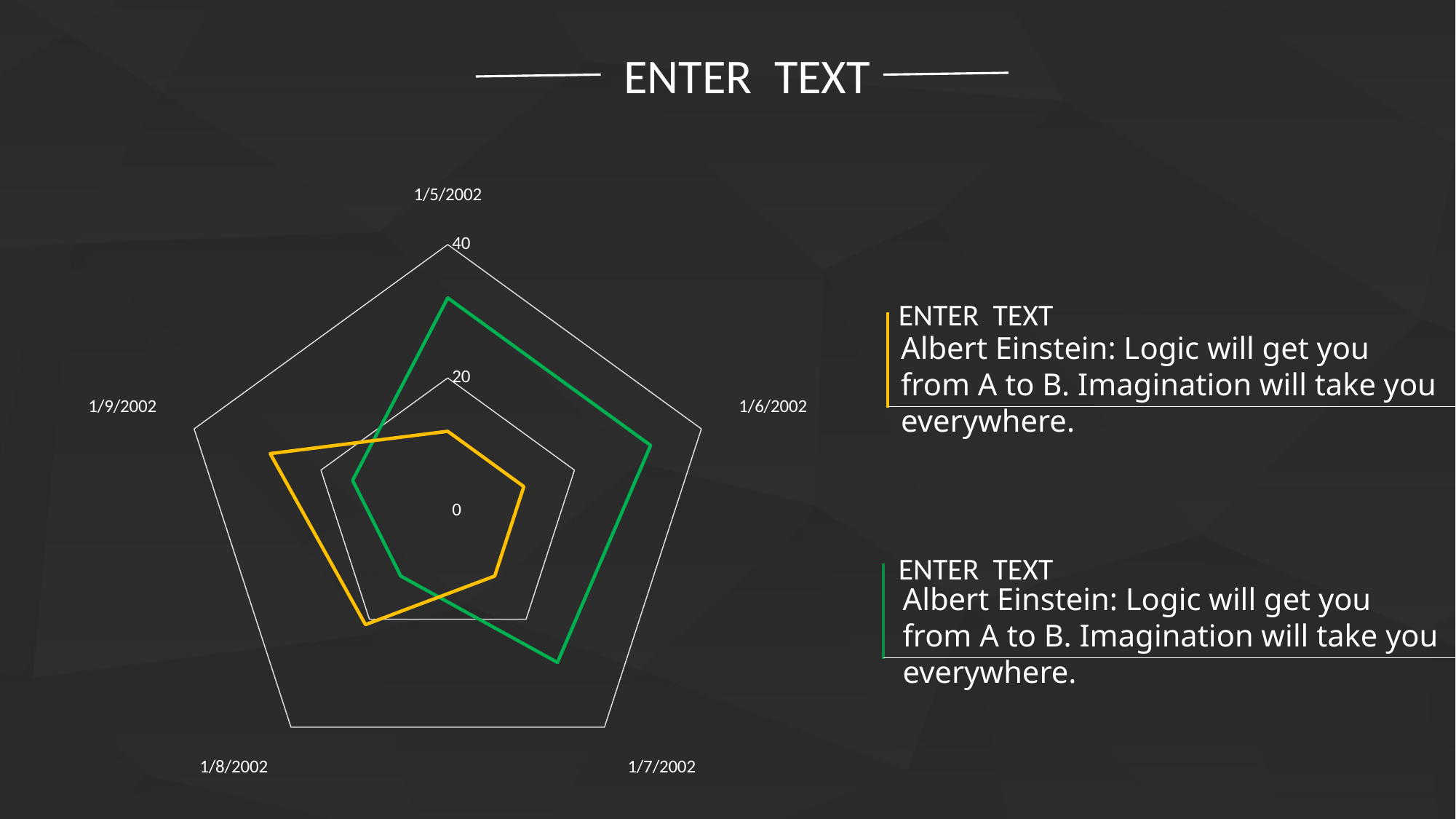
Is the yellow series value for 1/9/2002 greater or less than 20? greater Is the yellow series value for 1/6/2002 greater or less than 20? less Is the green series value for 1/8/2002 greater or less than 20? less What kind of chart is shown on the slide? radar chart How many data series are plotted on the radar chart? 2 How many categories (dates) are plotted on the radar chart? 5 For which category does the yellow series reach its highest value? 1/9/2002 For 1/9/2002, which series has the larger value, the green or the yellow? yellow For 1/5/2002, which series has the larger value, the green or the yellow? green What is the highest value shown on the radar chart's axis scale? 40